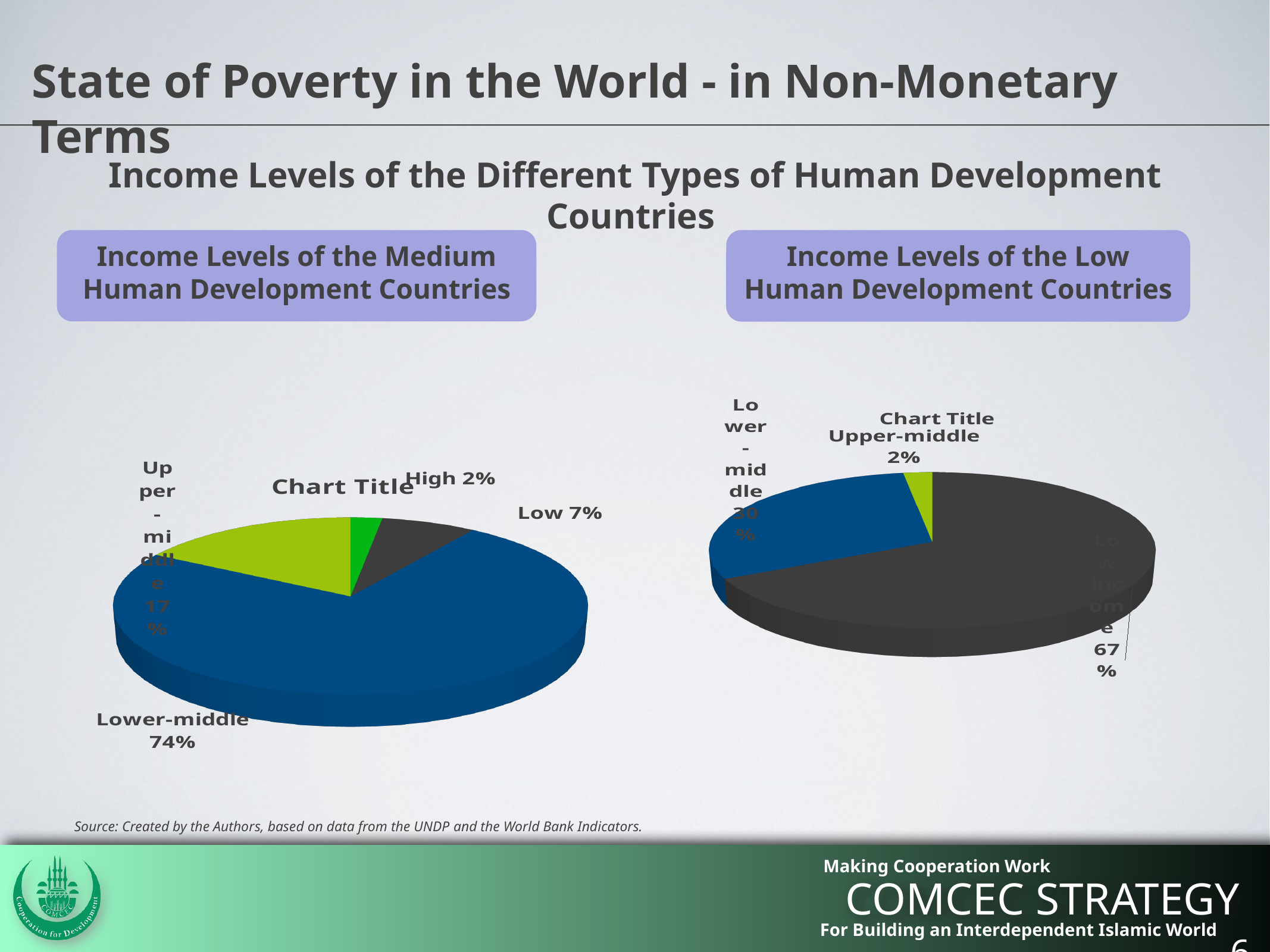
In the Income Levels of the Medium Human Development Countries chart, which category has the smallest share? High What kind of chart is the Income Levels of the Low Human Development Countries chart? Pie chart In the Income Levels of the Medium Human Development Countries chart, how many percentage points larger is Lower-middle than Upper-middle? 57 In the Income Levels of the Medium Human Development Countries chart, what share is High? 2% In the Income Levels of the Low Human Development Countries chart, what share is Upper-middle? 2% In the Income Levels of the Medium Human Development Countries chart, what share is Lower-middle? 74% In the Income Levels of the Low Human Development Countries chart, what share is Lower-middle? 30% In the Income Levels of the Medium Human Development Countries chart, which category has the largest share? Lower-middle How many slices does the Income Levels of the Medium Human Development Countries pie chart have? 4 In the Income Levels of the Medium Human Development Countries chart, what share is Low? 7% In the Income Levels of the Low Human Development Countries chart, which category has the smallest share? Upper-middle In the Income Levels of the Medium Human Development Countries chart, what share is Upper-middle? 17%